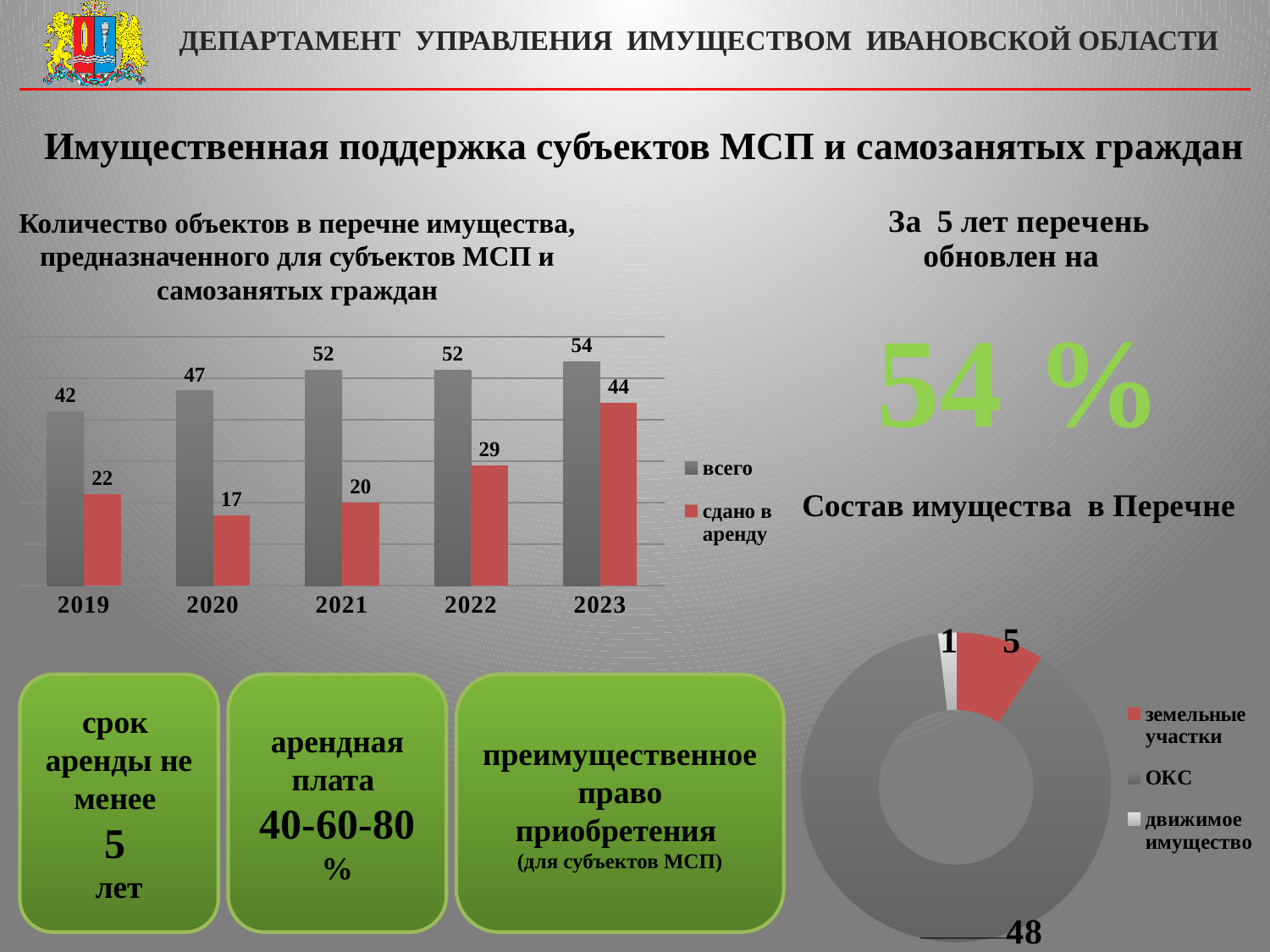
In the bar chart on the left, does the value of "всего" generally rise or fall from 2019 to 2023? rise In the chart titled "Состав имущества в Перечне", which category has the smallest value? движимое имущество In the chart titled "Состав имущества в Перечне", what is the value for "ОКС"? 48 In the bar chart on the left, which year has the lowest value for "сдано в аренду"? 2020 In the bar chart on the left, which year has the highest value for "всего"? 2023 What kind of chart is the chart titled "Состав имущества в Перечне"? doughnut chart In the bar chart on the left, how many years are shown on the x axis? 5 In the bar chart on the left, what is the difference between "всего" and "сдано в аренду" in 2023? 10 In the bar chart on the left, what is the value of "всего" for 2021? 52 In the bar chart on the left, how many series does the legend list? 2 In the bar chart on the left, which is larger: "сдано в аренду" in 2022 or in 2019? 2022 In the bar chart on the left, what is the value of "сдано в аренду" for 2020? 17